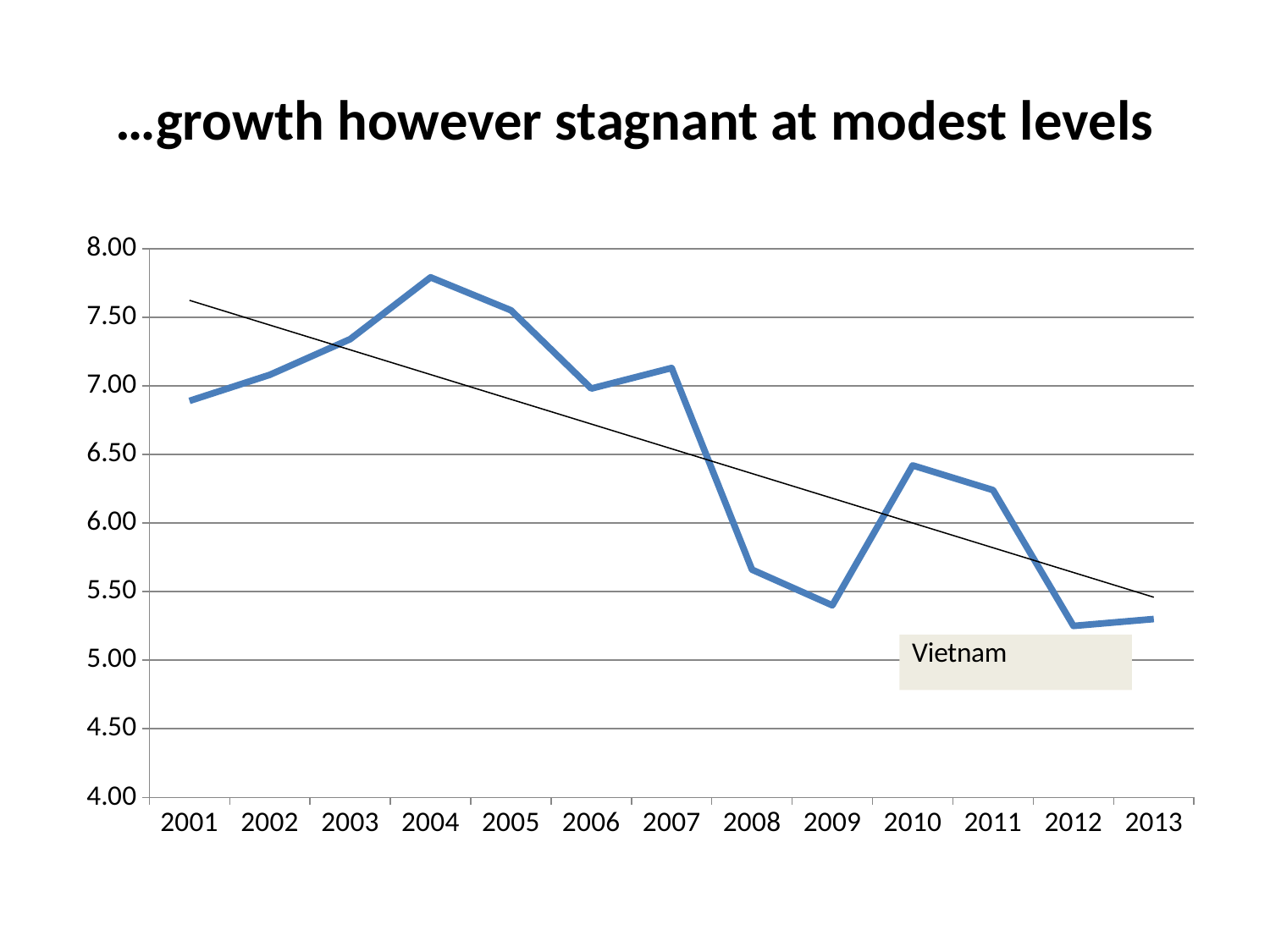
Is the value for 2012 greater or less than 5.50? less Is the value for 2008 greater or less than 6.00? less Which country is named in the label on the chart? Vietnam What kind of chart is shown on the slide? line chart Is the value for 2004 greater or less than 7.50? greater Which year has the larger value, 2008 or 2010? 2010 Which year has the larger value, 2004 or 2009? 2004 How many years are plotted along the x axis? 13 Which year has the highest value on the line? 2004 Does the trend line drawn across the chart rise or fall from 2001 to 2013? fall